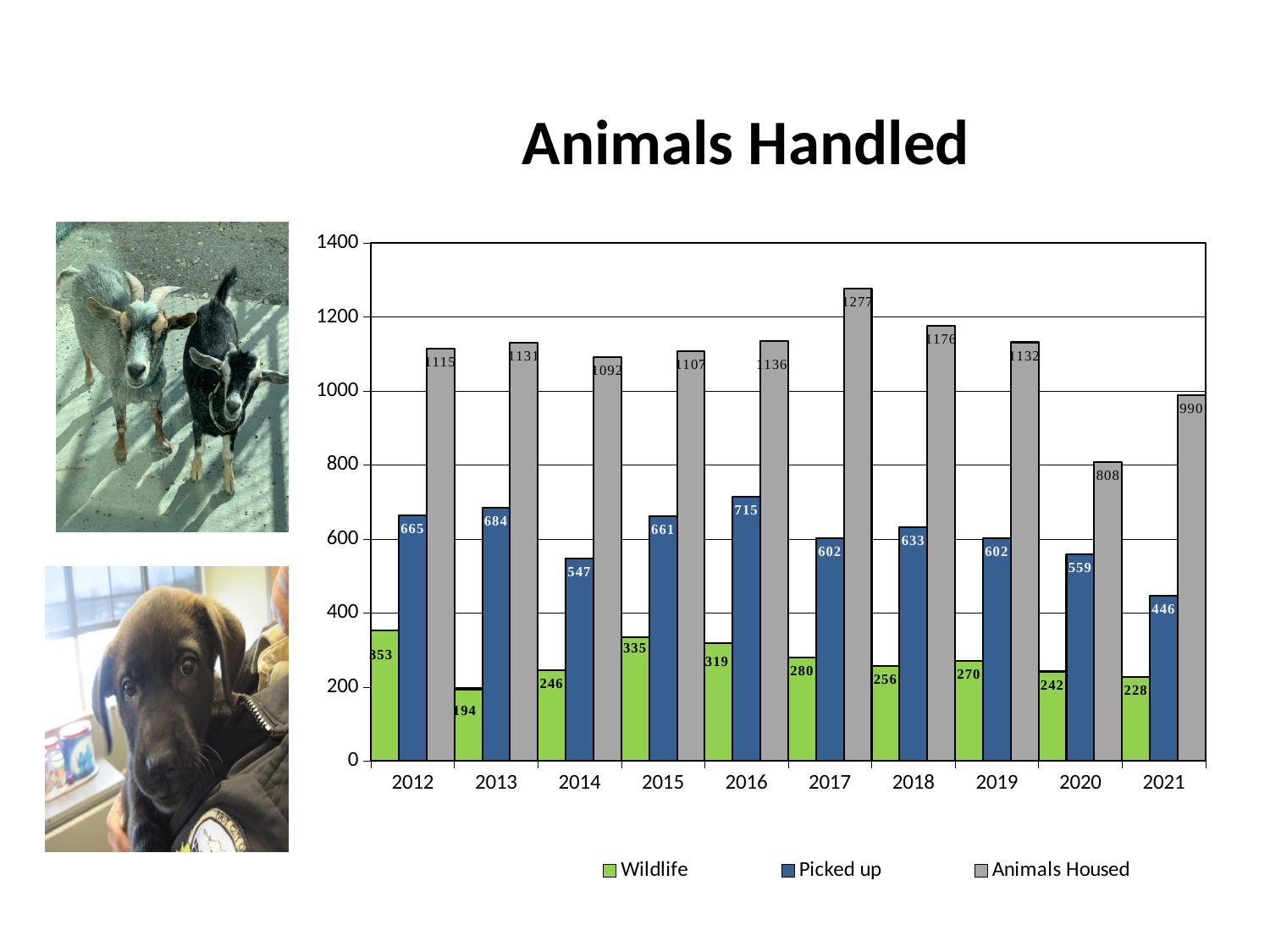
Is the Animals Housed value for 2020 greater or less than 1000? less What is the title of the chart? Animals Handled Which year has the highest Animals Housed value? 2017 How many series does the legend list? 3 How many years are shown on the x axis? 10 What is the difference between the Animals Housed values for 2021 and 2020? 182 What is the Animals Housed value for 2017? 1277 What is the Picked up value for 2014? 547 What is the Wildlife value for 2013? 194 Which is larger, the Picked up value for 2016 or for 2018? 2016 Which year has the lowest Picked up value? 2021 What type of chart is shown on the slide? Bar chart